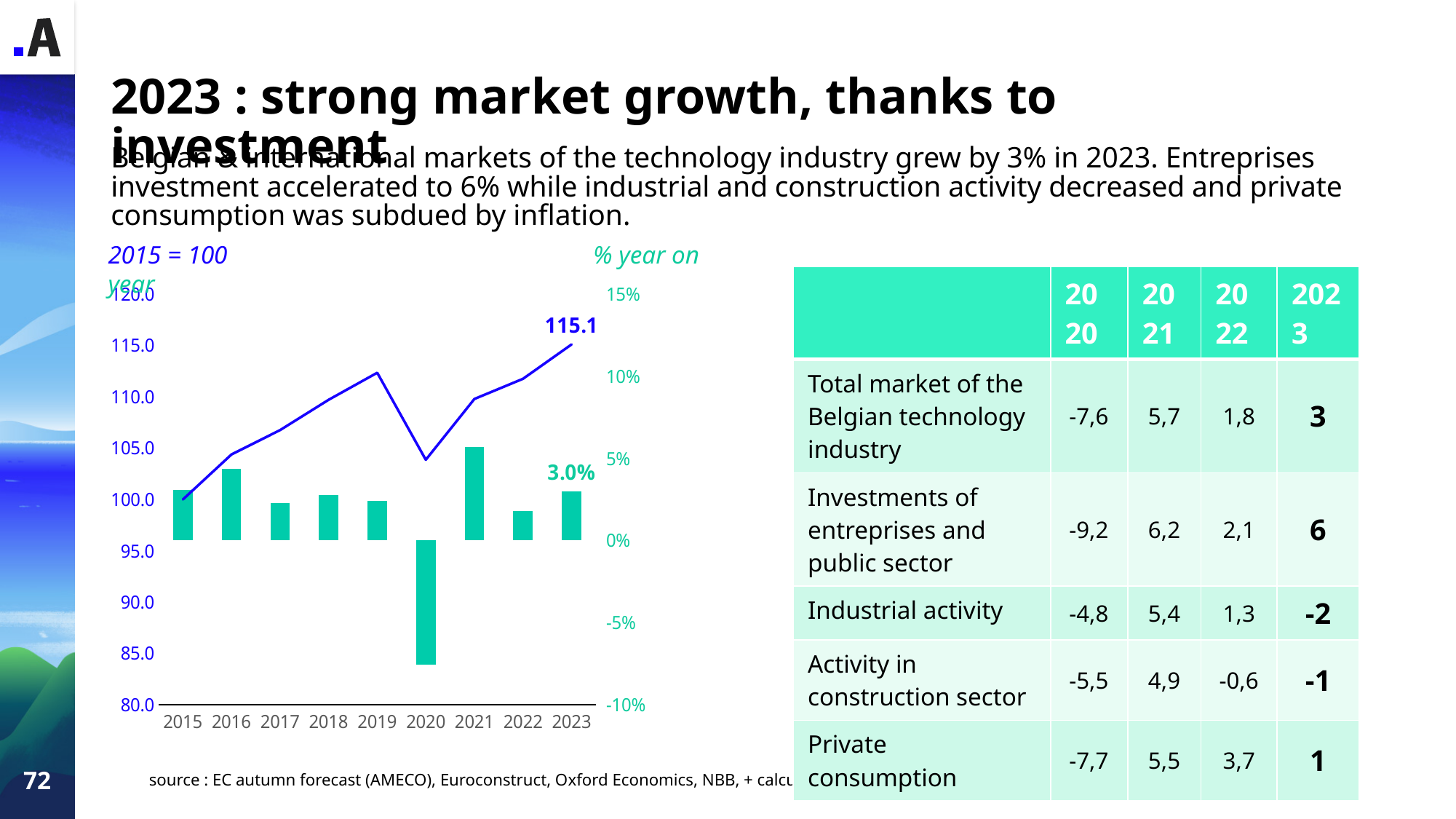
What kind of chart is shown on the slide? Combined bar and line chart What is the data label on the index line (2015 = 100) for 2023? 115.1 Is the index line value for 2020 greater or less than 105.0? less Does the index line rise or fall from 2020 to 2023? rise Which year has a higher index line value, 2019 or 2020? 2019 What is the data label on the bar for 2023 (% year on year)? 3.0% In which year does the index line (2015 = 100) reach its highest value? 2023 How many years are shown on the x axis of the chart? 9 Which year has the lowest bar (% year on year)? 2020 Is the bar value for 2020 greater or less than -5%? less Which year has the highest bar (% year on year)? 2021 Is the index line value for 2019 greater or less than 110.0? greater